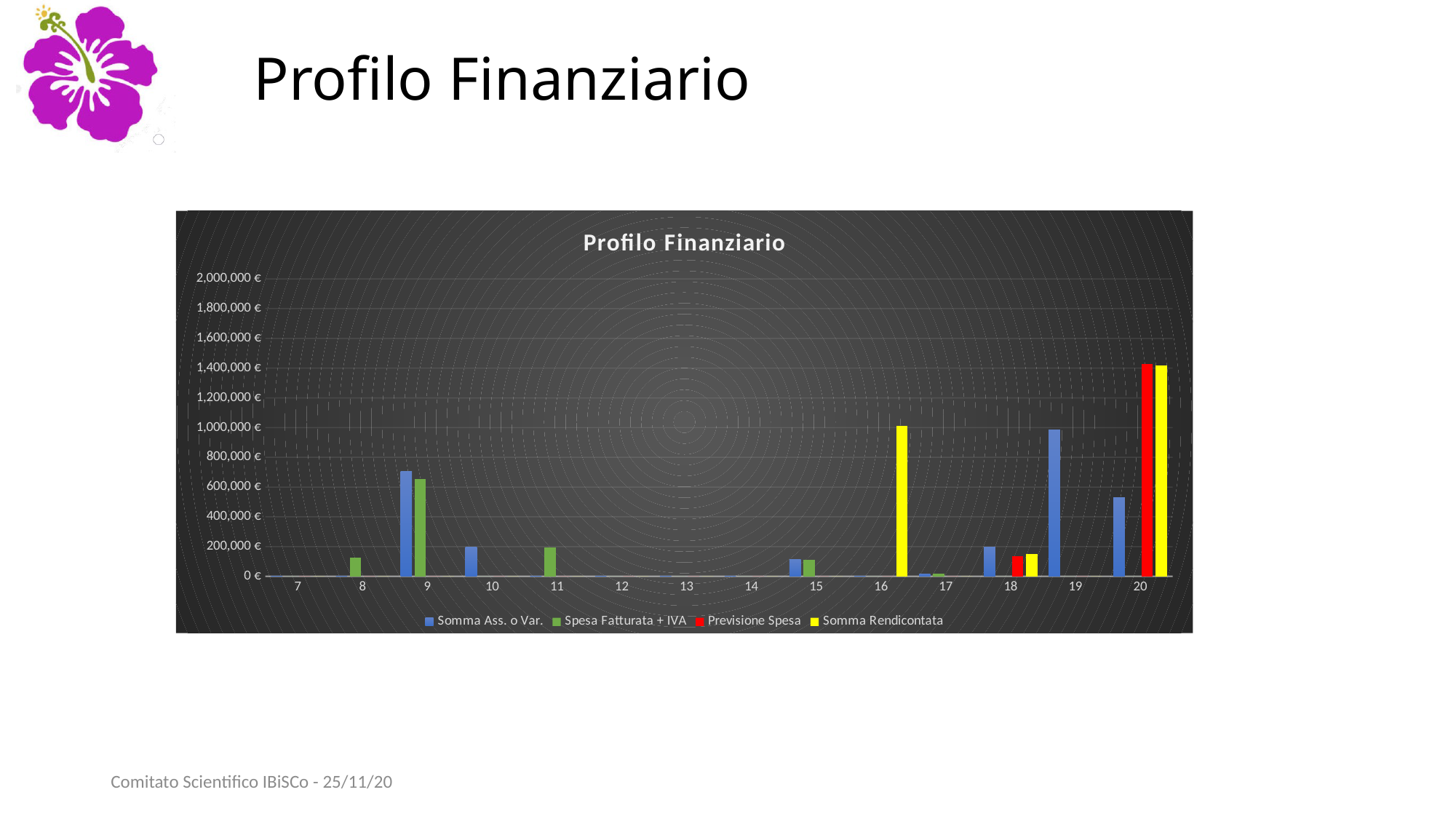
Which series is shown in red? Previsione Spesa Is the value of Somma Ass. o Var. at category 9 greater or less than 600,000 €? greater Is the value of Previsione Spesa at category 20 greater or less than 1,200,000 €? greater Which series has the tallest bar in the chart? Previsione Spesa How many series does the legend list? 4 What kind of chart is shown on the slide? bar chart Which is larger: Somma Rendicontata at category 16 or Somma Rendicontata at category 18? category 16 How many categories are shown on the x axis? 14 Is the value of Spesa Fatturata + IVA at category 8 greater or less than 200,000 €? less What is the title of the chart? Profilo Finanziario Which is larger: Somma Ass. o Var. at category 19 or Somma Ass. o Var. at category 20? category 19